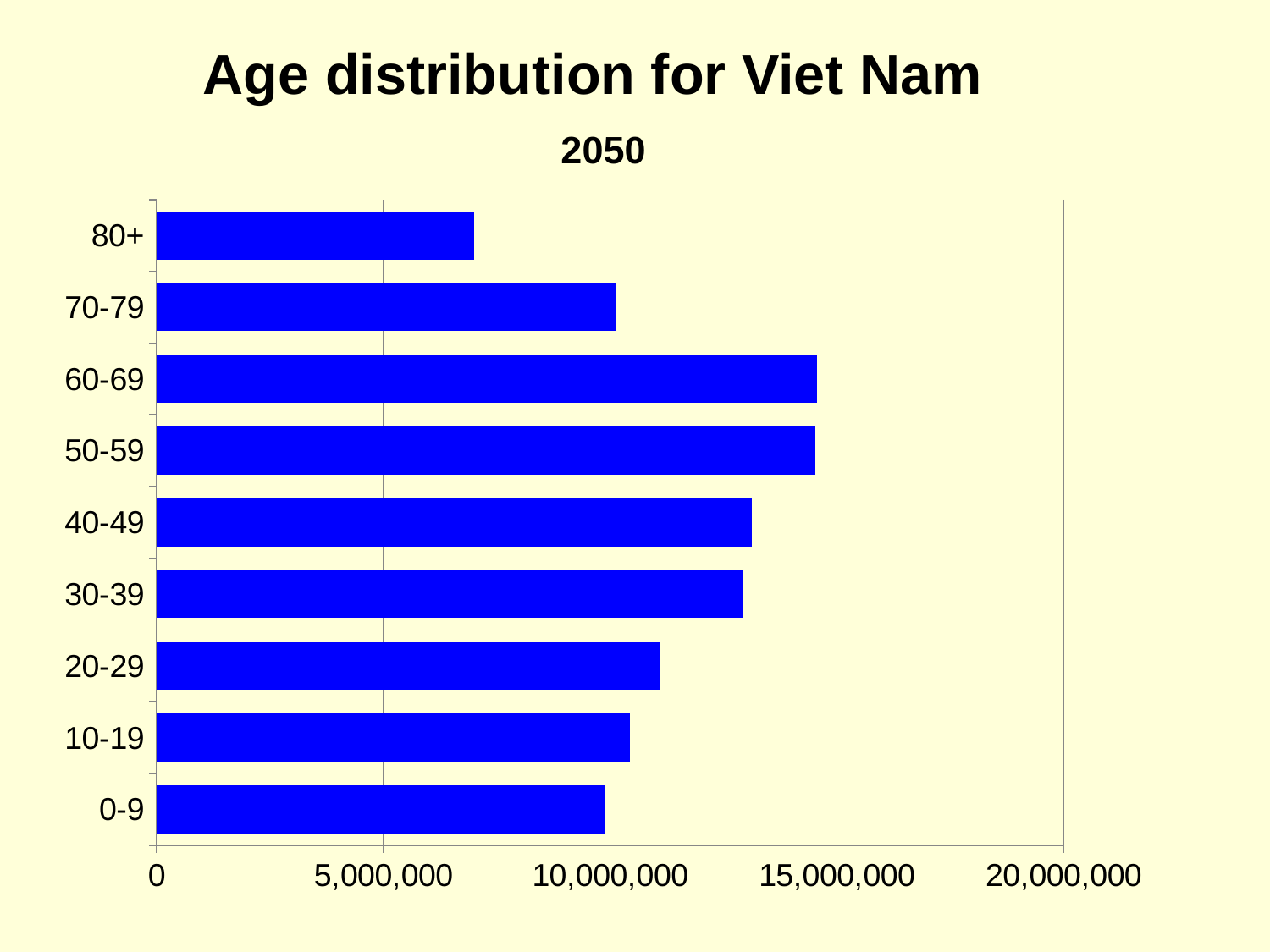
Is the value for the 40-49 age group greater or less than 10,000,000? greater Is the value for the 60-69 age group greater or less than 15,000,000? less Which has the larger value, the 40-49 age group or the 20-29 age group? 40-49 Which age group has the lowest value in the chart? 80+ Is the value for the 30-39 age group greater or less than 15,000,000? less What is the title of the chart? 2050 How many age groups are plotted in the chart? 9 Which has the larger value, the 0-9 age group or the 80+ age group? 0-9 What year does the chart subtitle refer to? 2050 What kind of chart is shown on the slide? bar chart